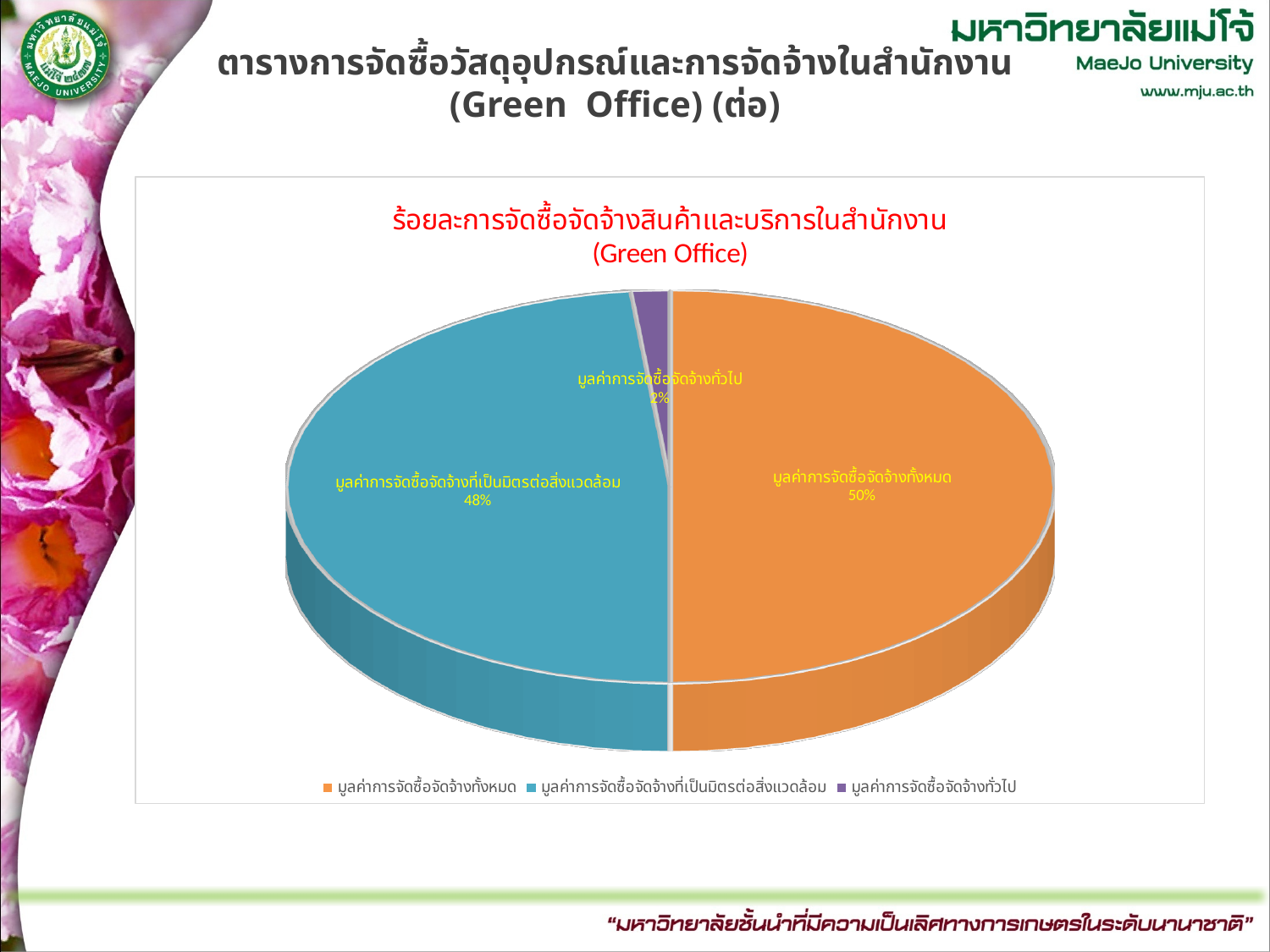
What colour is the slice for มูลค่าการจัดซื้อจัดจ้างทั่วไป? Purple Which slice of the pie is the largest? มูลค่าการจัดซื้อจัดจ้างทั้งหมด What percentage is shown for มูลค่าการจัดซื้อจัดจ้างทั้งหมด? 50% How many slices does the pie chart have? 3 What percentage is shown for มูลค่าการจัดซื้อจัดจ้างทั่วไป? 2% What is the difference in percentage points between มูลค่าการจัดซื้อจัดจ้างที่เป็นมิตรต่อสิ่งแวดล้อม and มูลค่าการจัดซื้อจัดจ้างทั่วไป? 46 percentage points What percentage is shown for มูลค่าการจัดซื้อจัดจ้างที่เป็นมิตรต่อสิ่งแวดล้อม? 48% What kind of chart is shown on the slide? Pie chart What is the difference in percentage points between มูลค่าการจัดซื้อจัดจ้างทั้งหมด and มูลค่าการจัดซื้อจัดจ้างที่เป็นมิตรต่อสิ่งแวดล้อม? 2 percentage points What is the title of the pie chart? ร้อยละการจัดซื้อจัดจ้างสินค้าและบริการในสำนักงาน (Green Office) Which is larger, the slice for มูลค่าการจัดซื้อจัดจ้างที่เป็นมิตรต่อสิ่งแวดล้อม or the slice for มูลค่าการจัดซื้อจัดจ้างทั่วไป? มูลค่าการจัดซื้อจัดจ้างที่เป็นมิตรต่อสิ่งแวดล้อม Which slice of the pie is the smallest? มูลค่าการจัดซื้อจัดจ้างทั่วไป